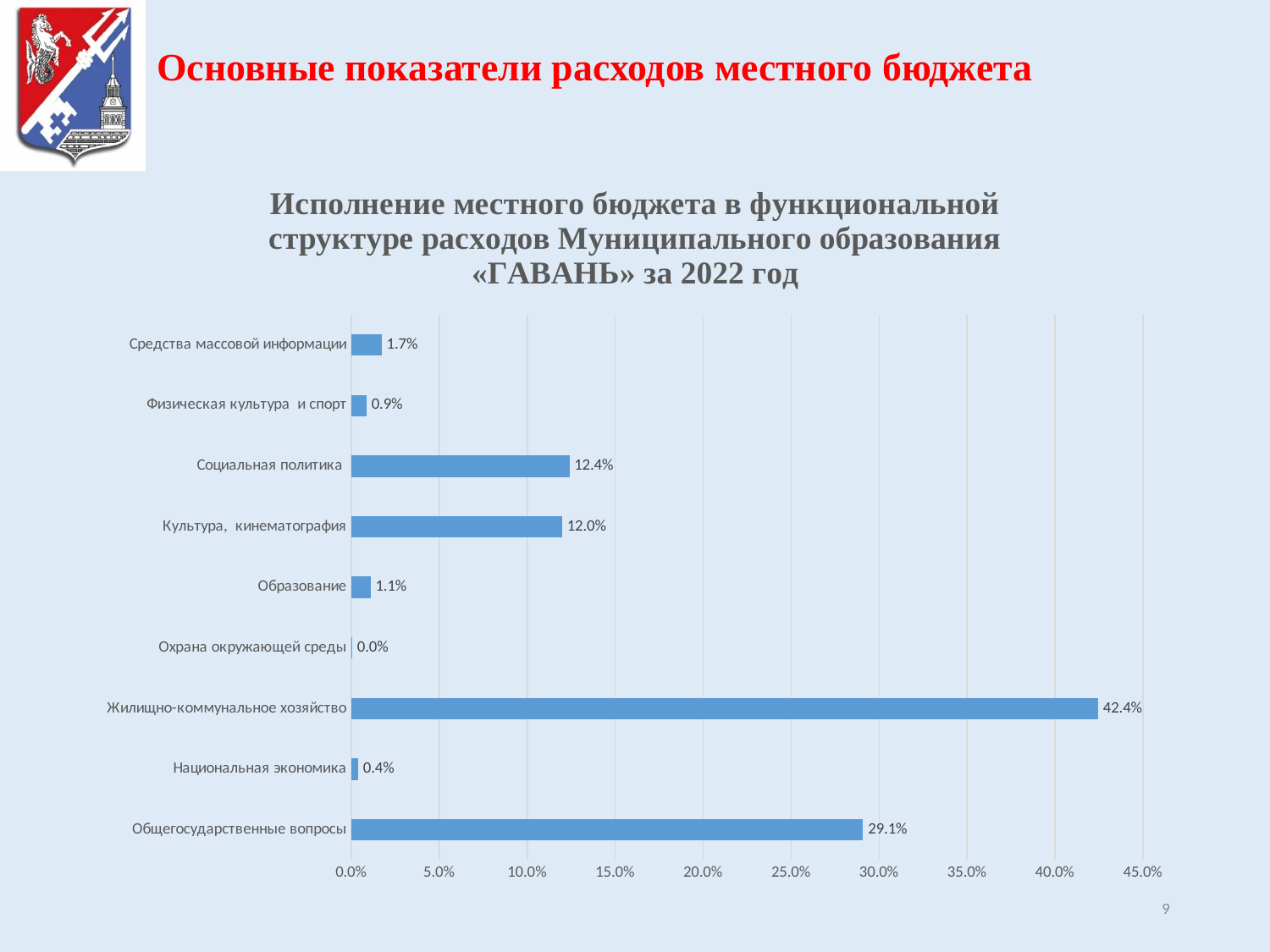
What is the value for Социальная политика? 12.4% How many categories are shown in the chart? 9 What is the value for Жилищно-коммунальное хозяйство? 42.4% What is the value for Средства массовой информации? 1.7% What is the value for Охрана окружающей среды? 0.0% What kind of chart is shown on the slide? Bar chart Which category has the lowest value? Охрана окружающей среды What is the value for Общегосударственные вопросы? 29.1% Is the value for Общегосударственные вопросы greater or less than 25.0%? greater Which category has the highest value? Жилищно-коммунальное хозяйство What is the difference between Жилищно-коммунальное хозяйство and Общегосударственные вопросы? 13.3% Which is larger, Социальная политика or Культура, кинематография? Социальная политика